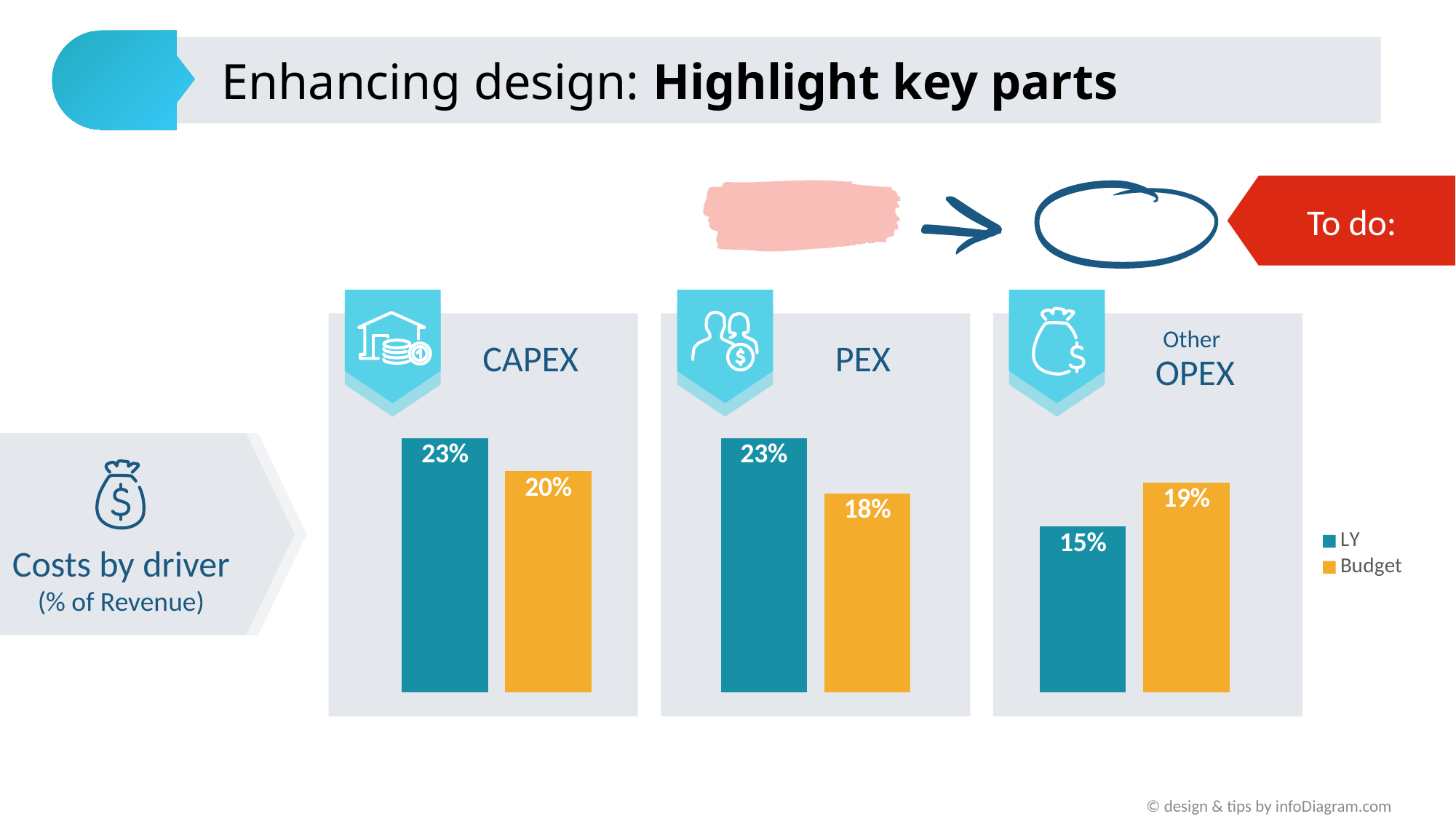
How many series does the legend list? 2 What is the LY value for Other OPEX? 15% What kind of chart is shown? Bar chart What is the Budget value for PEX? 18% What is the difference between the LY and Budget values for PEX? 5% For Other OPEX, which is larger, LY or Budget? Budget What unit are the chart values expressed in, according to the label on the left? % of Revenue What is the Budget value for Other OPEX? 19% Which category has the highest Budget value? CAPEX What is the LY value for CAPEX? 23% Which category has the lowest LY value? Other OPEX How many cost categories are shown in the chart? 3